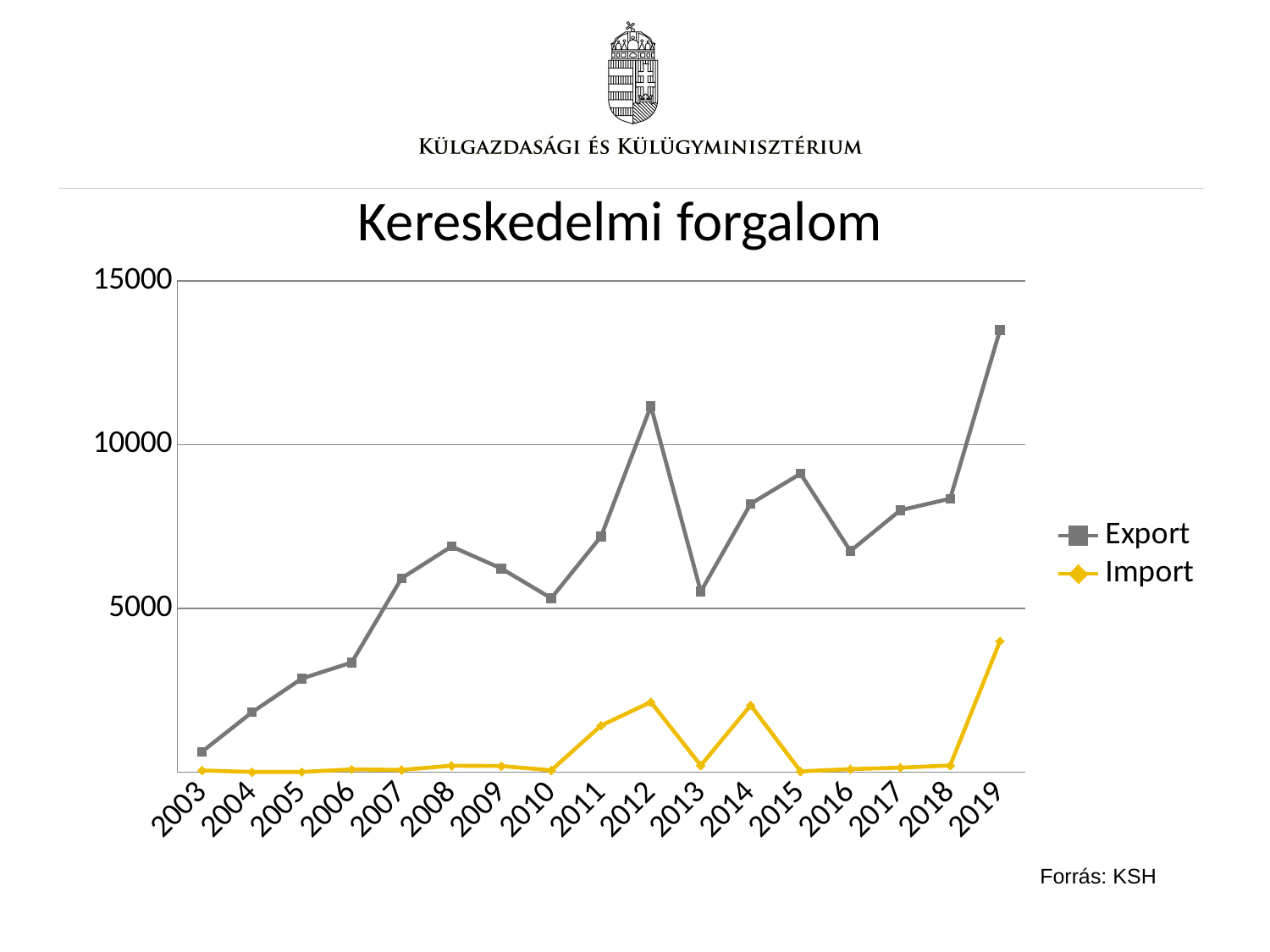
In which year is the Export value lowest? 2003 How many series does the legend list? 2 In which year is the Export value highest? 2019 How many years are plotted along the x axis? 17 What is the title of the chart? Kereskedelmi forgalom Is the Export value for 2013 greater or less than 10000? less Is the Import value for 2019 greater or less than 5000? less Which is larger, the Export value for 2012 or the Export value for 2015? 2012 Does the Export line rise or fall between 2016 and 2019? rise What kind of chart is shown on the slide? line chart In which year is the Import value highest? 2019 Is the Export value for 2012 greater or less than 10000? greater